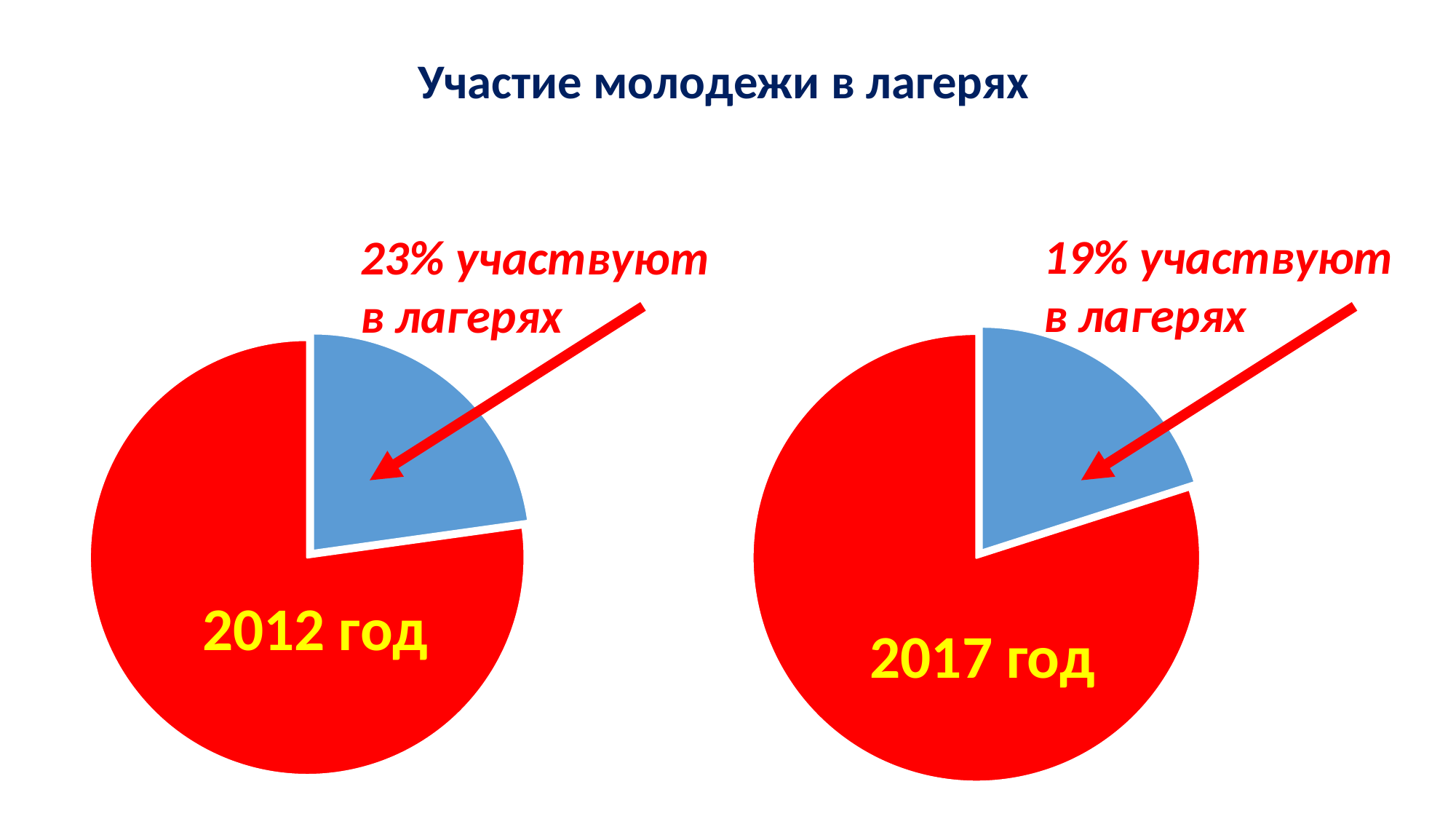
By how many percentage points did the share of youth participating in camps change from the 2012 год pie chart to the 2017 год pie chart? 4 percentage points How many pie charts are shown on the slide? 2 In the 2017 год pie chart, what colour is the slice representing youth who participate in camps? Blue What kind of chart is used for the 2012 год data on the slide? Pie chart How many slices does the 2012 год pie chart have? 2 What is the title of the slide containing the two pie charts? Участие молодежи в лагерях How many slices does the 2017 год pie chart have? 2 Did the share of youth participating in camps rise or fall from 2012 год to 2017 год? Fall In the 2017 год pie chart, what share of youth participate in camps (участвуют в лагерях)? 19% In the 2012 год pie chart, what share of youth participate in camps (участвуют в лагерях)? 23% Comparing the two pie charts, which year has the larger share of youth participating in camps, 2012 год or 2017 год? 2012 год